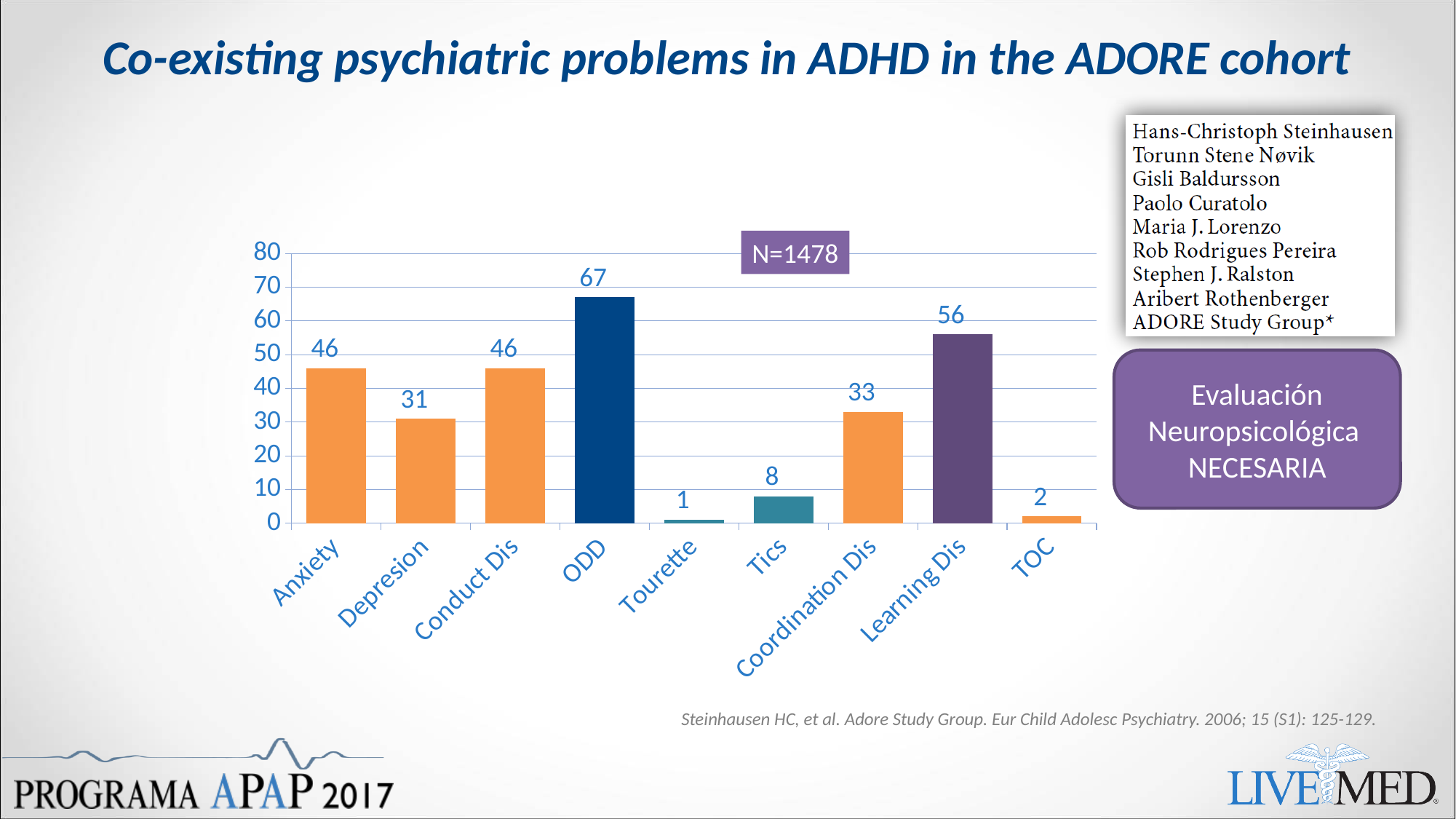
How many categories are shown on the x axis? 9 What is the value for Learning Dis? 56 What kind of chart is shown on the slide? Bar chart What is the value for Coordination Dis? 33 Which is larger, the value for Tics or the value for TOC? Tics What is the value for Depresion? 31 What is the value for ODD? 67 Which category has the highest value? ODD What sample size (N) is shown in the box above the chart? N=1478 Which category has the lowest value? Tourette What is the difference between the values for ODD and Learning Dis? 11 What is the difference between the values for Anxiety and Depresion? 15